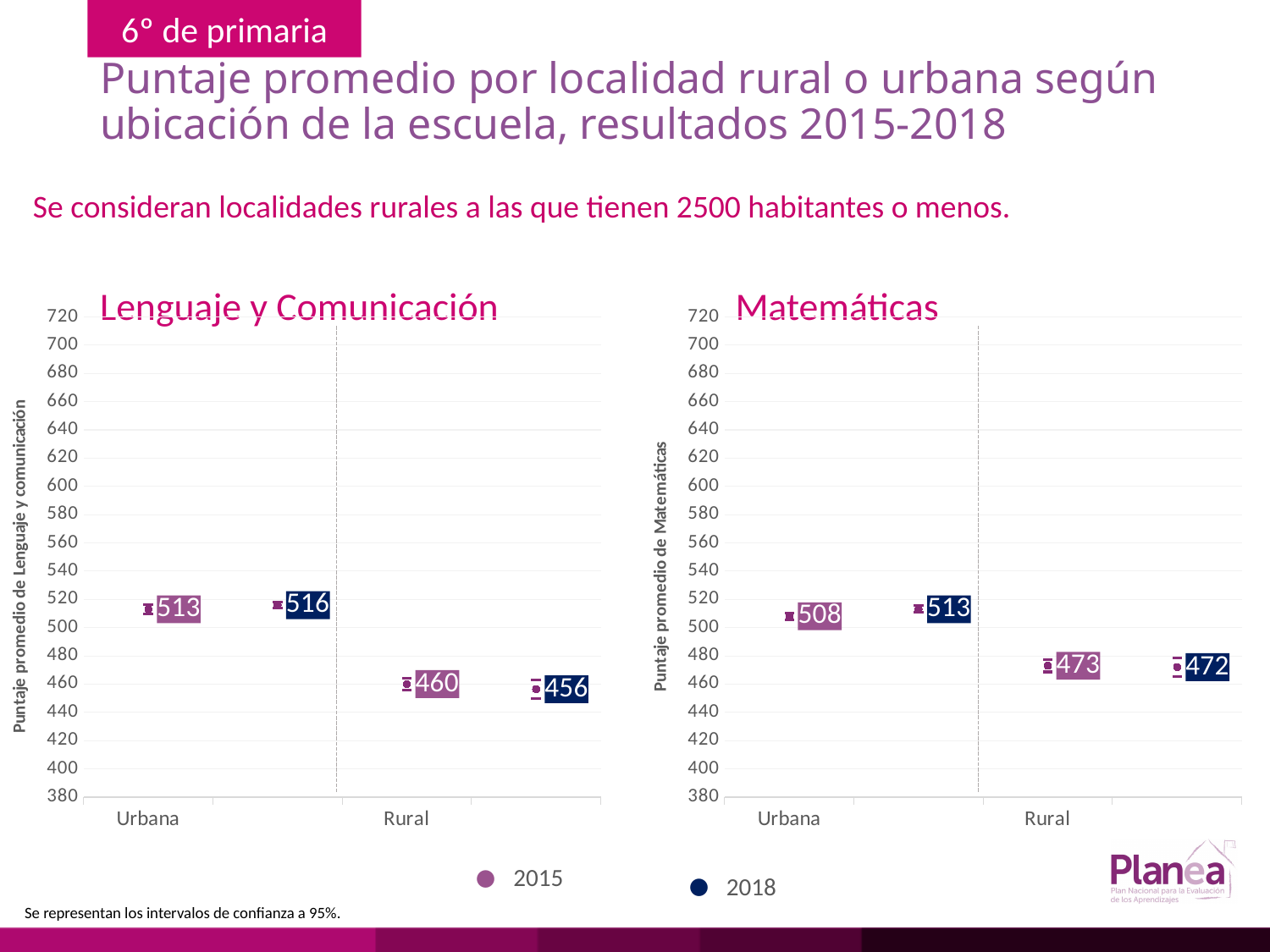
How many series does the legend list? 2 In the Matemáticas chart, what is the difference between the 2018 and 2015 values for Urbana? 5 In the Lenguaje y Comunicación chart, what is the 2018 value for Rural? 456 Which colour represents the 2018 series in the legend? Dark blue In the Matemáticas chart, what is the 2018 value for Rural? 472 In the Lenguaje y Comunicación chart, what is the 2015 value for Urbana? 513 In the Matemáticas chart, which is larger for Rural: the 2015 value or the 2018 value? 2015 In the Lenguaje y Comunicación chart, what is the difference between the Urbana and Rural values for 2018? 60 In the Lenguaje y Comunicación chart, is the 2015 value for Rural greater or less than 480? less In the Lenguaje y Comunicación chart, which category has the highest 2018 value? Urbana In the Matemáticas chart, what is the 2015 value for Urbana? 508 How many categories are shown on the x axis of the Matemáticas chart? 2